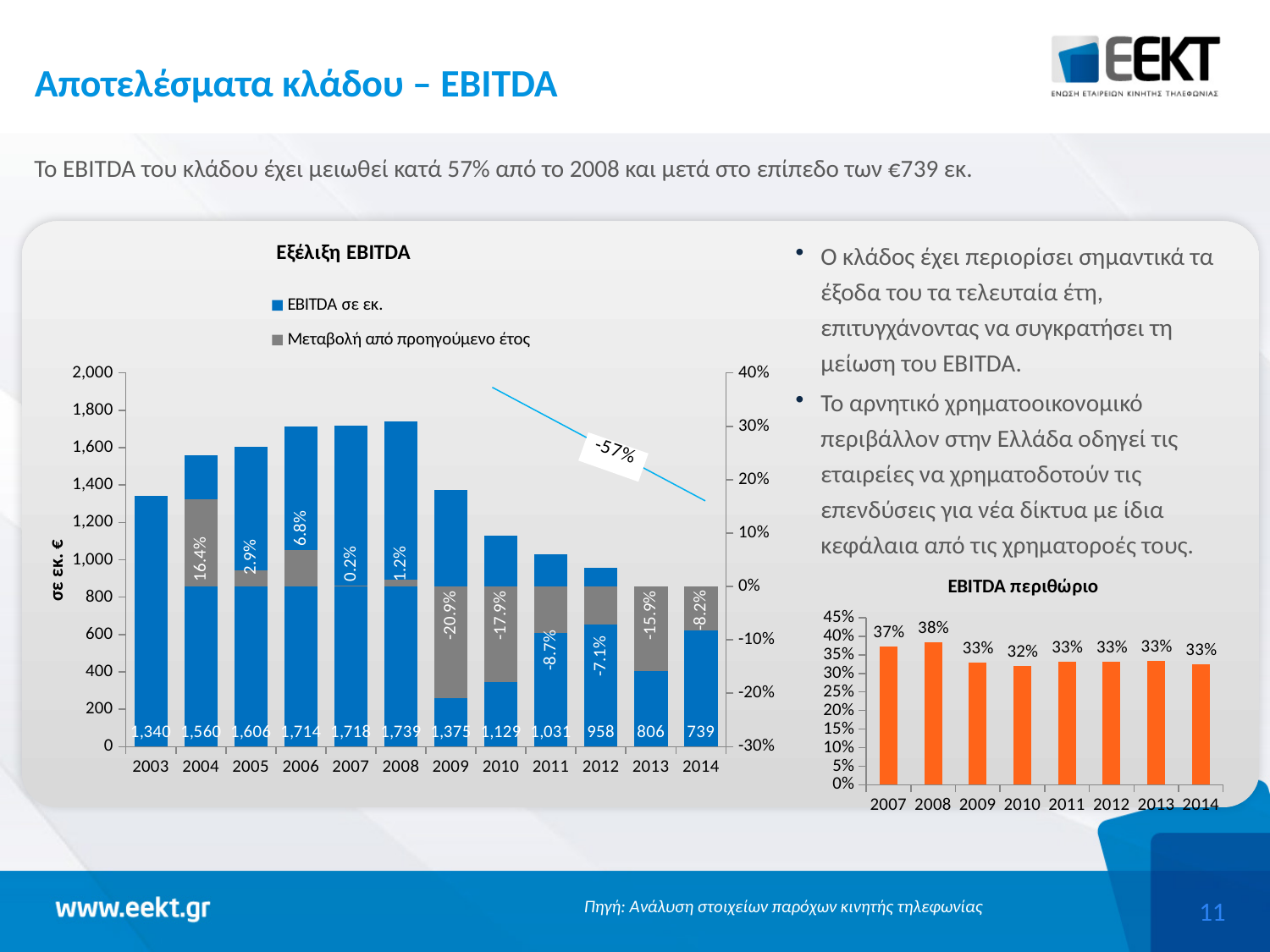
In the 'Εξέλιξη EBITDA' chart, how many series does the legend list? 2 In the 'EBITDA περιθώριο' chart, what is the value for 2008? 38% In the 'Εξέλιξη EBITDA' chart, what is the difference between the EBITDA values for 2008 and 2014? 1,000 In the 'EBITDA περιθώριο' chart, which year has the lowest value? 2010 In the 'Εξέλιξη EBITDA' chart, what is the EBITDA value for 2008? 1,739 In the 'EBITDA περιθώριο' chart, how many years are shown? 8 In the 'Εξέλιξη EBITDA' chart, which year has the lowest EBITDA value? 2014 In the 'Εξέλιξη EBITDA' chart, what is the EBITDA value for 2014? 739 In the 'Εξέλιξη EBITDA' chart, what is the year-on-year change shown for 2009? -20.9% What kind of chart is the 'EBITDA περιθώριο' chart? bar chart In the 'Εξέλιξη EBITDA' chart, do the EBITDA values rise or fall from 2008 to 2014? fall In the 'Εξέλιξη EBITDA' chart, which year has the highest EBITDA value? 2008